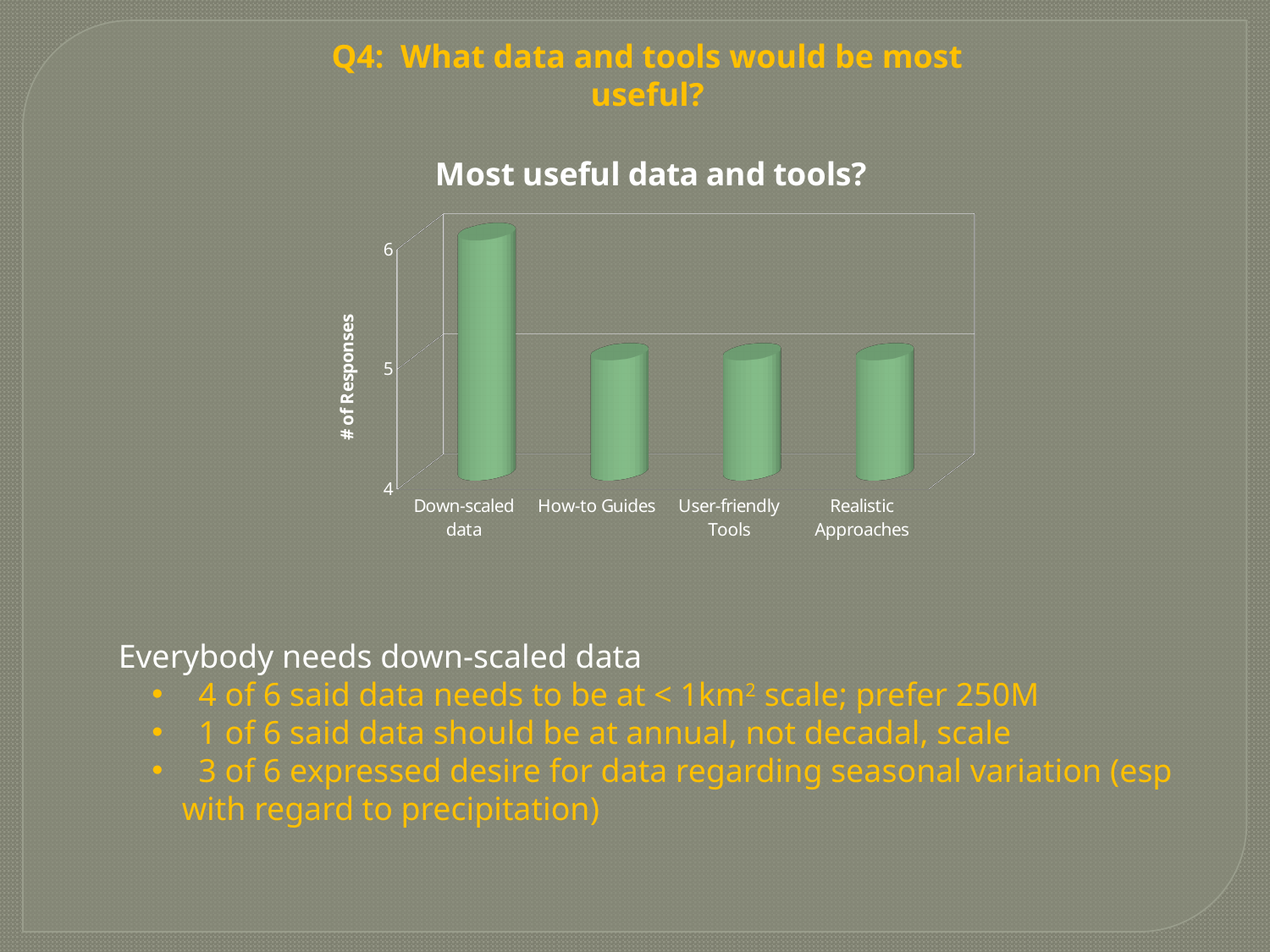
Which has more responses, Down-scaled data or How-to Guides? Down-scaled data Which category has the highest number of responses? Down-scaled data Which has more responses, Realistic Approaches or Down-scaled data? Down-scaled data What is the lowest tick value shown on the vertical axis? 4 What is the title of the chart? Most useful data and tools? Is the value for User-friendly Tools greater or less than 4? greater Is the value for How-to Guides greater or less than 6? less How many categories are shown on the x axis of the chart? 4 Is the value for Down-scaled data greater or less than 5? greater What is the label on the vertical axis of the chart? # of Responses What type of chart is shown on the slide? bar chart